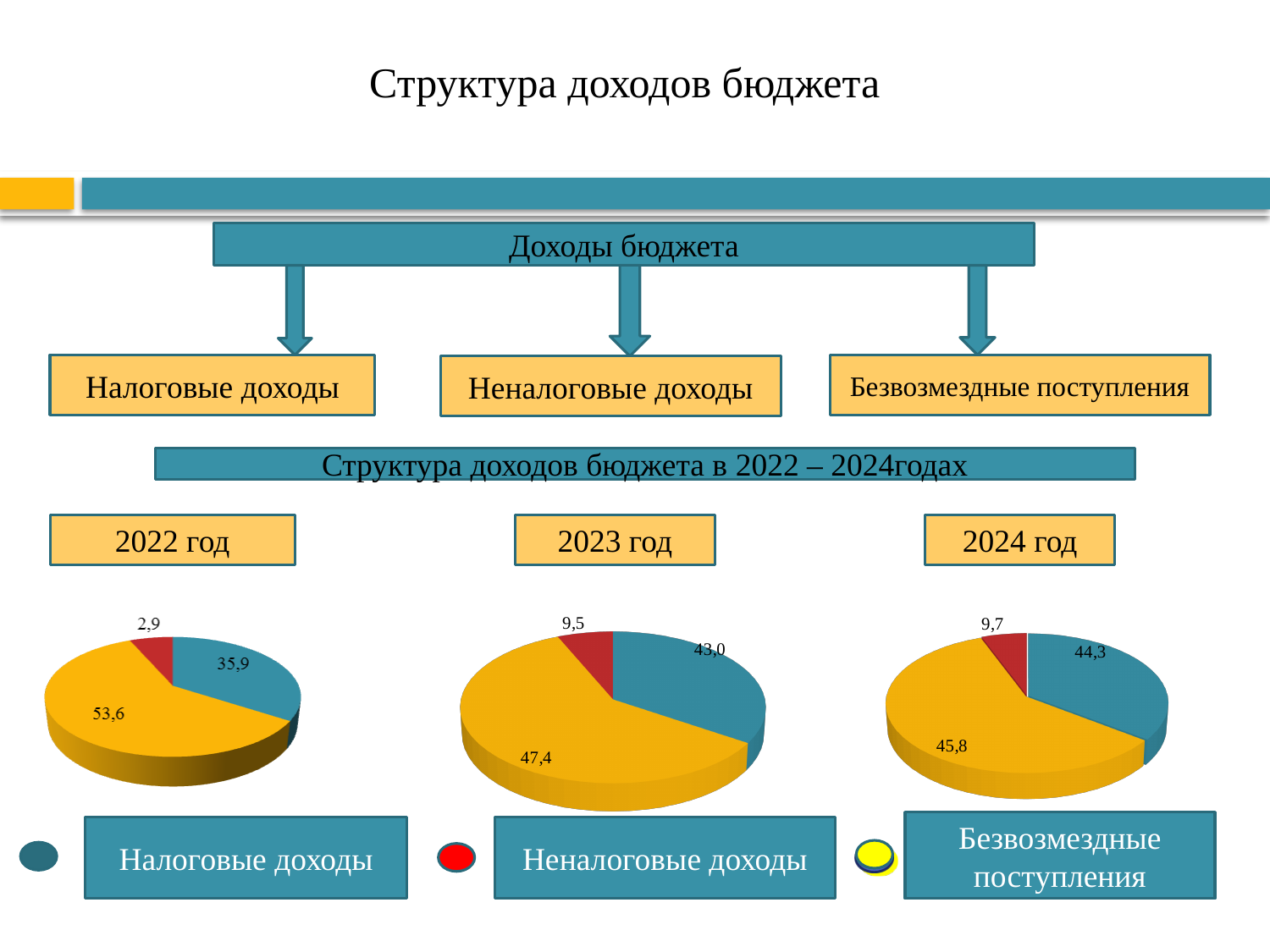
In the 2022 год pie chart, what is the value for Налоговые доходы? 35,9 How many slices does the 2023 год pie chart have? 3 Across the 2022, 2023 and 2024 pie charts, does the value for Налоговые доходы rise or fall over the years? Rise In the 2023 год pie chart, which category has the smallest slice? Неналоговые доходы In the 2024 год pie chart, what is the value for Неналоговые доходы? 9,7 In the 2022 год pie chart, which category has the largest slice? Безвозмездные поступления What type of chart is used for the 2022 год data? Pie chart Which category does the red slice represent in the pie charts? Неналоговые доходы In the 2023 год pie chart, what is the value for Безвозмездные поступления? 47,4 In the 2023 год pie chart, what is the difference between the values for Налоговые доходы and Неналоговые доходы? 33,5 In the 2022 год pie chart, what is the difference between the values for Безвозмездные поступления and Налоговые доходы? 17,7 In the 2024 год pie chart, which is larger: Налоговые доходы or Безвозмездные поступления? Безвозмездные поступления